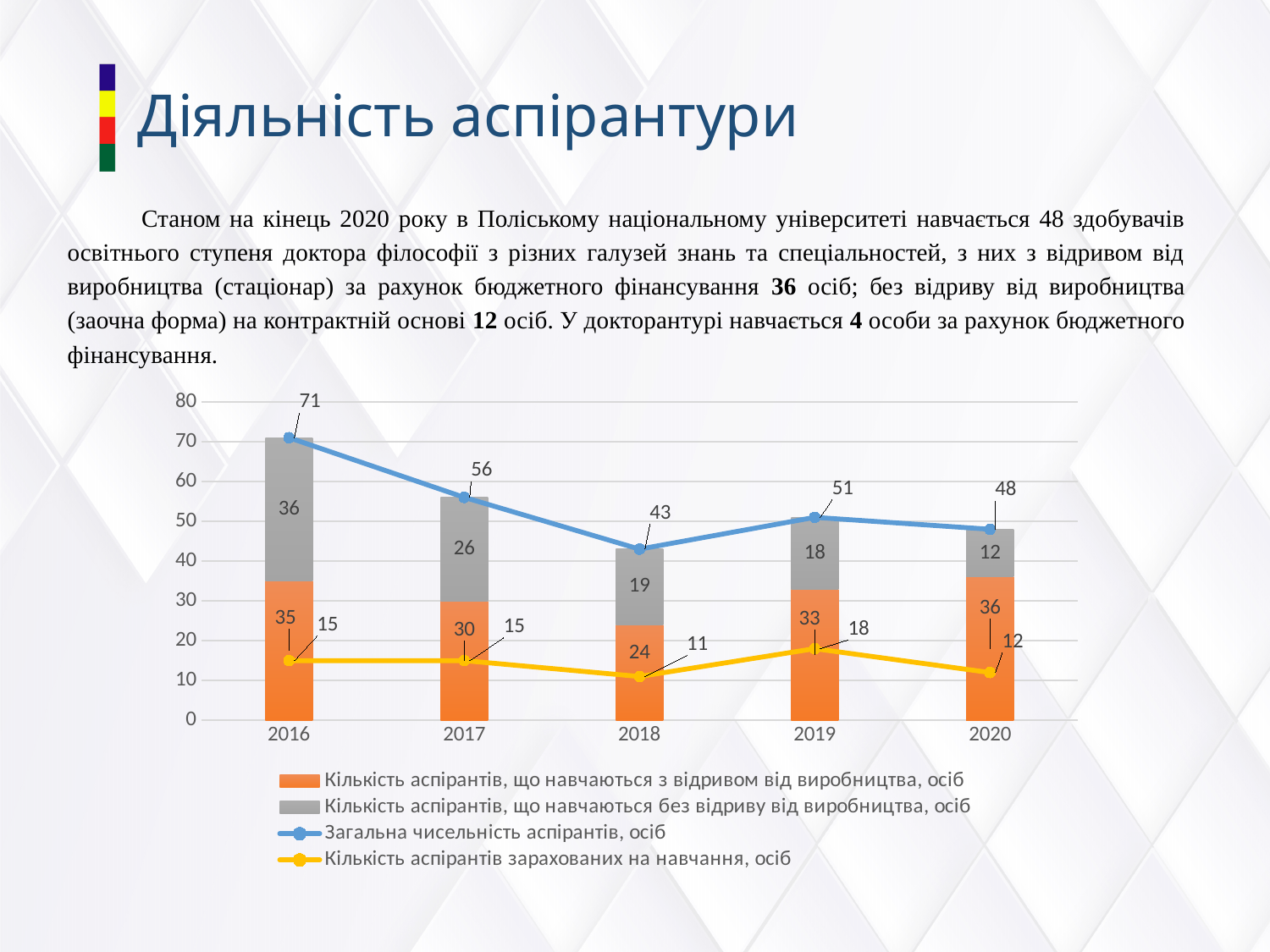
What is the value of 'Кількість аспірантів зарахованих на навчання, осіб' in 2019? 18 How many years are shown on the x axis? 5 Does 'Кількість аспірантів, що навчаються без відриву від виробництва, осіб' rise or fall from 2016 to 2020? Fall What is the difference between 'Загальна чисельність аспірантів, осіб' in 2016 and in 2020? 23 In which year is 'Кількість аспірантів, що навчаються з відривом від виробництва, осіб' the highest? 2020 What is the value of 'Кількість аспірантів, що навчаються без відриву від виробництва, осіб' in 2018? 19 Which is larger in 2017: 'Кількість аспірантів, що навчаються з відривом від виробництва, осіб' or 'Кількість аспірантів, що навчаються без відриву від виробництва, осіб'? Кількість аспірантів, що навчаються з відривом від виробництва, осіб What is the value of 'Загальна чисельність аспірантів, осіб' in 2016? 71 What kind of chart is shown on the slide? Combined stacked bar and line chart What is the total of the stacked bar for 2019? 51 In which year is 'Загальна чисельність аспірантів, осіб' the lowest? 2018 How many series does the legend list? 4